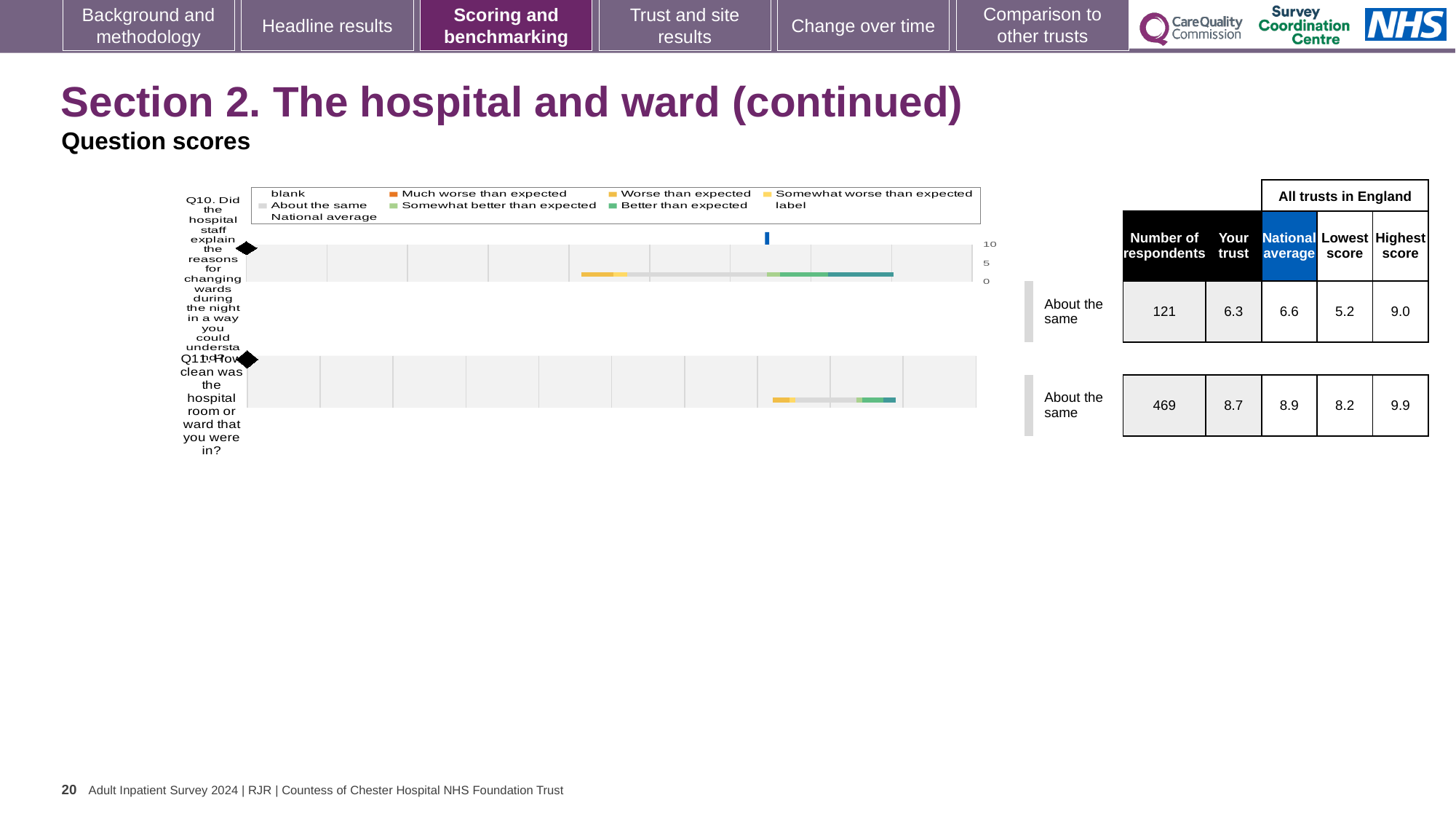
What is the maximum value shown on the chart's score axis? 10 Which question has the lower number of respondents? Q10 What is the national average score for Q11 (how clean was the hospital room or ward)? 8.9 Which legend entry is shown in orange, representing the worst benchmark category? Much worse than expected How many respondents answered Q11? 469 What kind of chart is shown on the slide? bar chart What is the difference between the highest score and the lowest score for Q10? 3.8 What is the difference between the national average and the trust's score for Q11? 0.2 What benchmark category is the trust's Q10 score placed in? About the same How many questions (categories) are plotted in the chart? 2 Which question has the higher trust score, Q10 or Q11? Q11 What is the trust's score for Q10 (explaining reasons for changing wards during the night)? 6.3